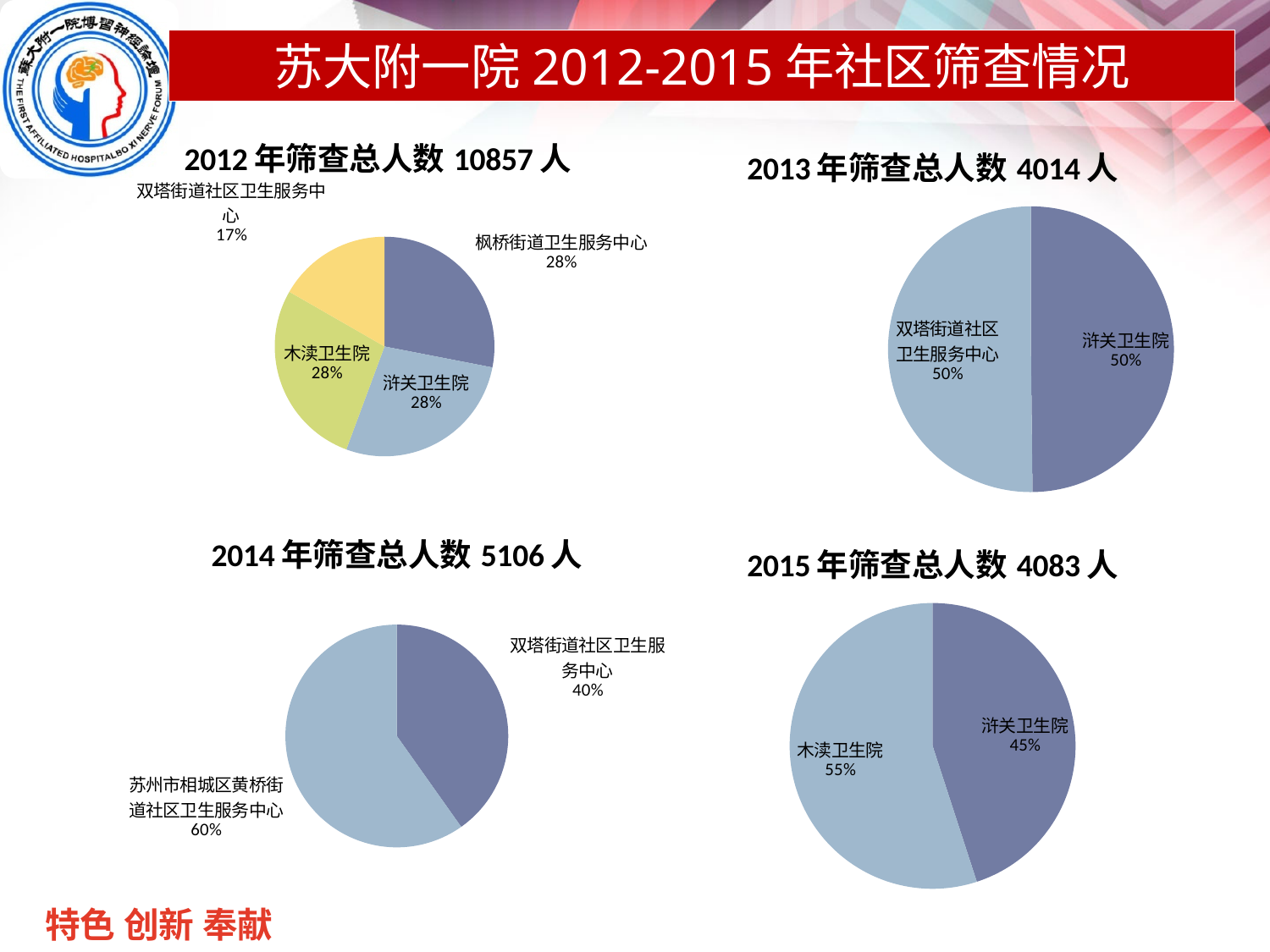
In the 2012 pie chart, what share does 枫桥街道卫生服务中心 have? 28% In the 2015 pie chart, which is larger, 木渎卫生院 or 浒关卫生院? 木渎卫生院 How many slices does the 2013 pie chart have? 2 How many slices does the 2012 pie chart have? 4 In the 2013 pie chart (2013年筛查总人数 4014人), what share does 浒关卫生院 have? 50% In the 2014 pie chart, which category has the larger share? 苏州市相城区黄桥街道社区卫生服务中心 In the 2015 pie chart (2015年筛查总人数 4083人), what share does 木渎卫生院 have? 55% In the 2014 pie chart, what is the difference in percentage points between 苏州市相城区黄桥街道社区卫生服务中心 and 双塔街道社区卫生服务中心? 20 percentage points In the 2012 pie chart, which category has the smallest share? 双塔街道社区卫生服务中心 What kind of chart is used for the 2013 screening data? Pie chart